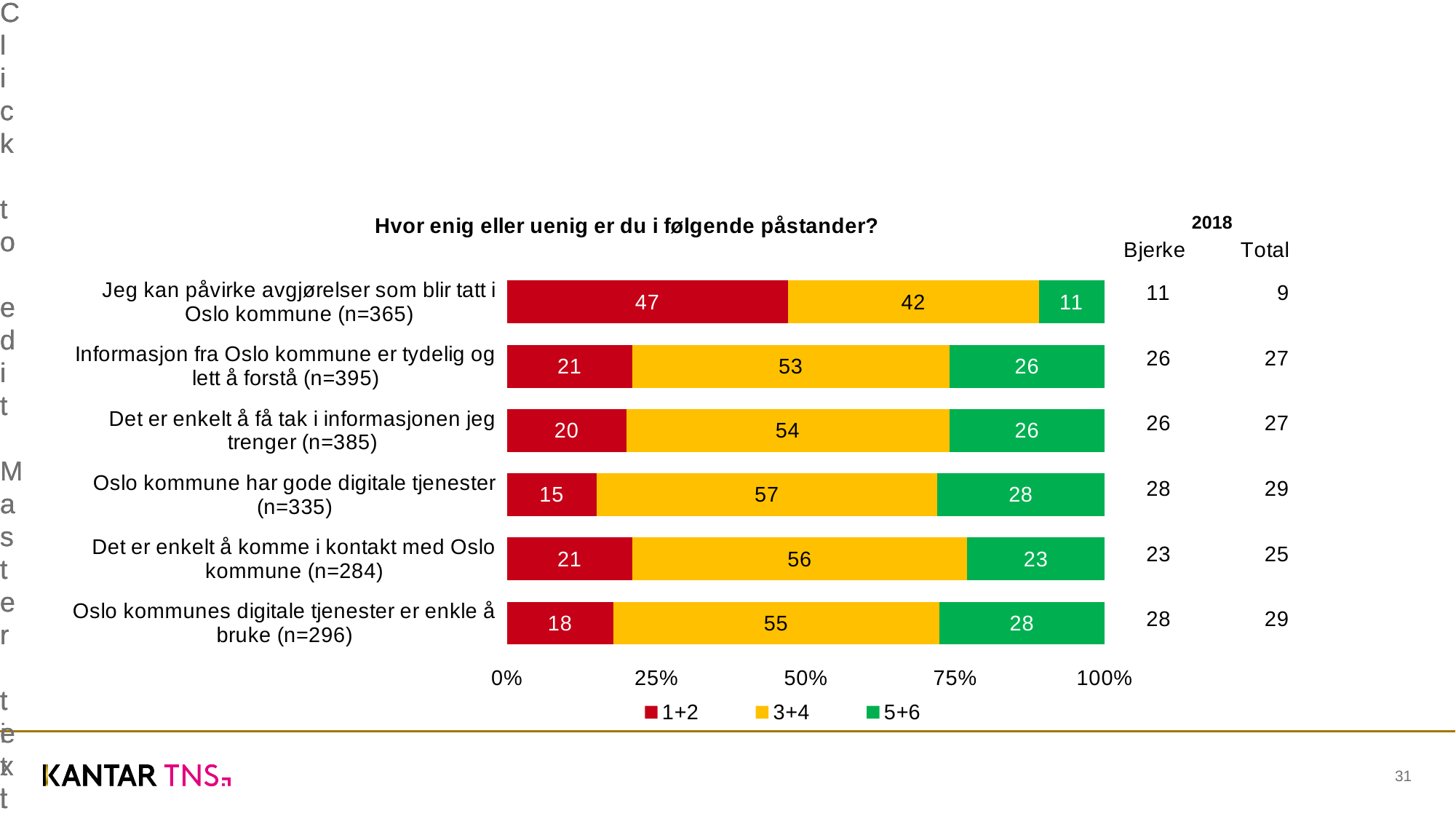
What is the difference between the 3+4 value for "Oslo kommune har gode digitale tjenester (n=335)" and the 3+4 value for "Jeg kan påvirke avgjørelser som blir tatt i Oslo kommune (n=365)"? 15 What is the value of the 5+6 segment for "Det er enkelt å komme i kontakt med Oslo kommune (n=284)"? 23 How many statements (categories) are plotted in the chart? 6 What colour represents the 5+6 series in the chart? Green How many series does the legend list? 3 What is the title of the chart? Hvor enig eller uenig er du i følgende påstander? What is the value of the 1+2 segment for "Jeg kan påvirke avgjørelser som blir tatt i Oslo kommune (n=365)"? 47 Which statement has the lowest 5+6 value? Jeg kan påvirke avgjørelser som blir tatt i Oslo kommune (n=365) What is the value of the 3+4 segment for "Oslo kommune har gode digitale tjenester (n=335)"? 57 What kind of chart is shown on the slide? Stacked bar chart Which statement has the highest 1+2 value? Jeg kan påvirke avgjørelser som blir tatt i Oslo kommune (n=365) Which is larger: the 1+2 value for "Oslo kommunes digitale tjenester er enkle å bruke (n=296)" or the 1+2 value for "Oslo kommune har gode digitale tjenester (n=335)"? Oslo kommunes digitale tjenester er enkle å bruke (n=296)